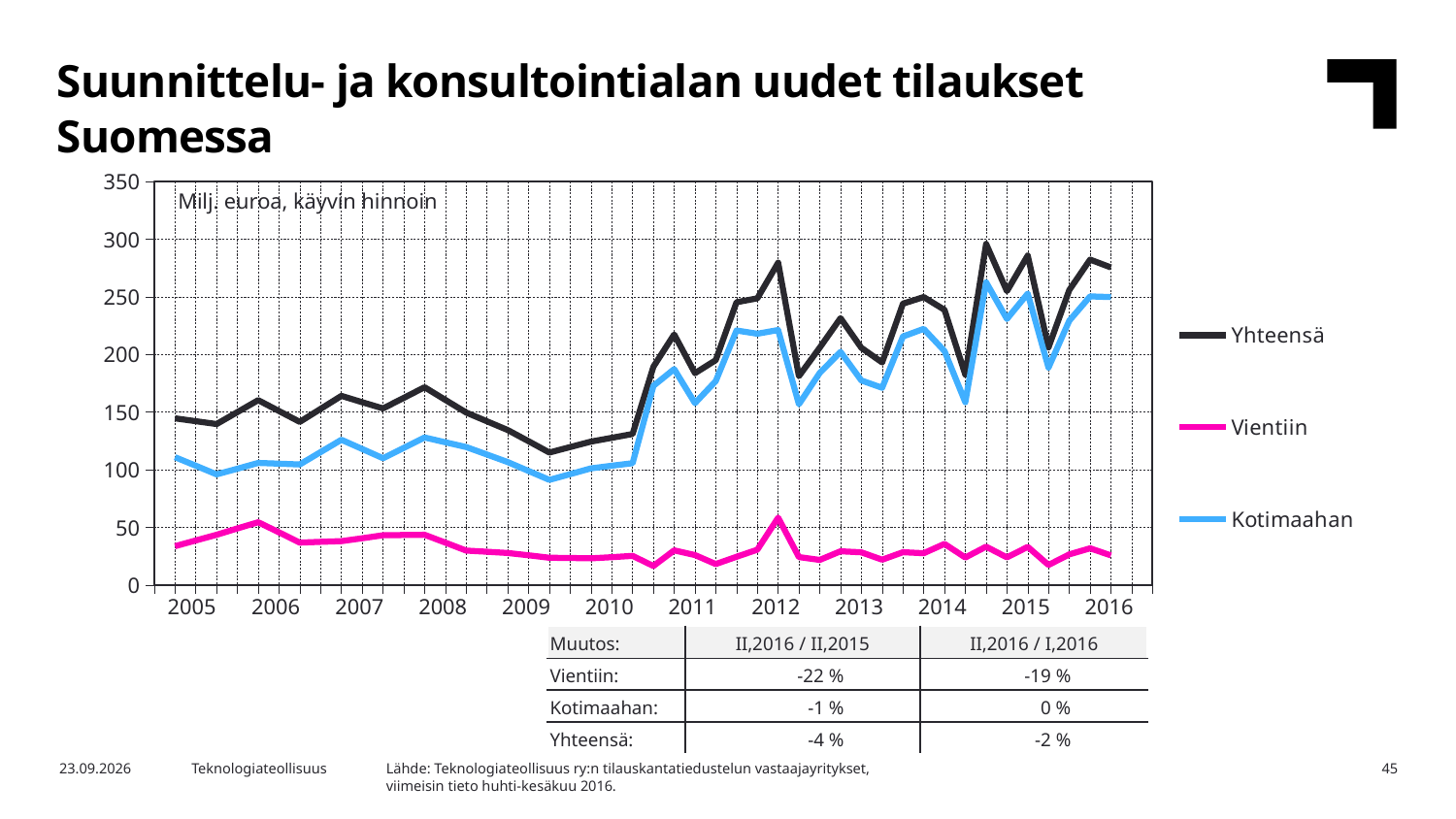
Is the highest point of the Vientiin line (around 2012) greater or less than 100? less Does the Yhteensä line overall rise or fall from 2005 to 2016? rise At 2010, which is larger: Kotimaahan or Vientiin? Kotimaahan Is the value for Yhteensä at the start of 2005 greater or less than 100? greater What kind of chart is shown on the slide? line chart What unit label is printed inside the chart area? Milj. euroa, käyvin hinnoin Is the value for Vientiin at the start of 2005 greater or less than 100? less How many series does the legend list? 3 Which series has the highest values throughout the chart? Yhteensä Which series has the lowest values throughout the chart? Vientiin What are the three series named in the legend? Yhteensä, Vientiin, Kotimaahan